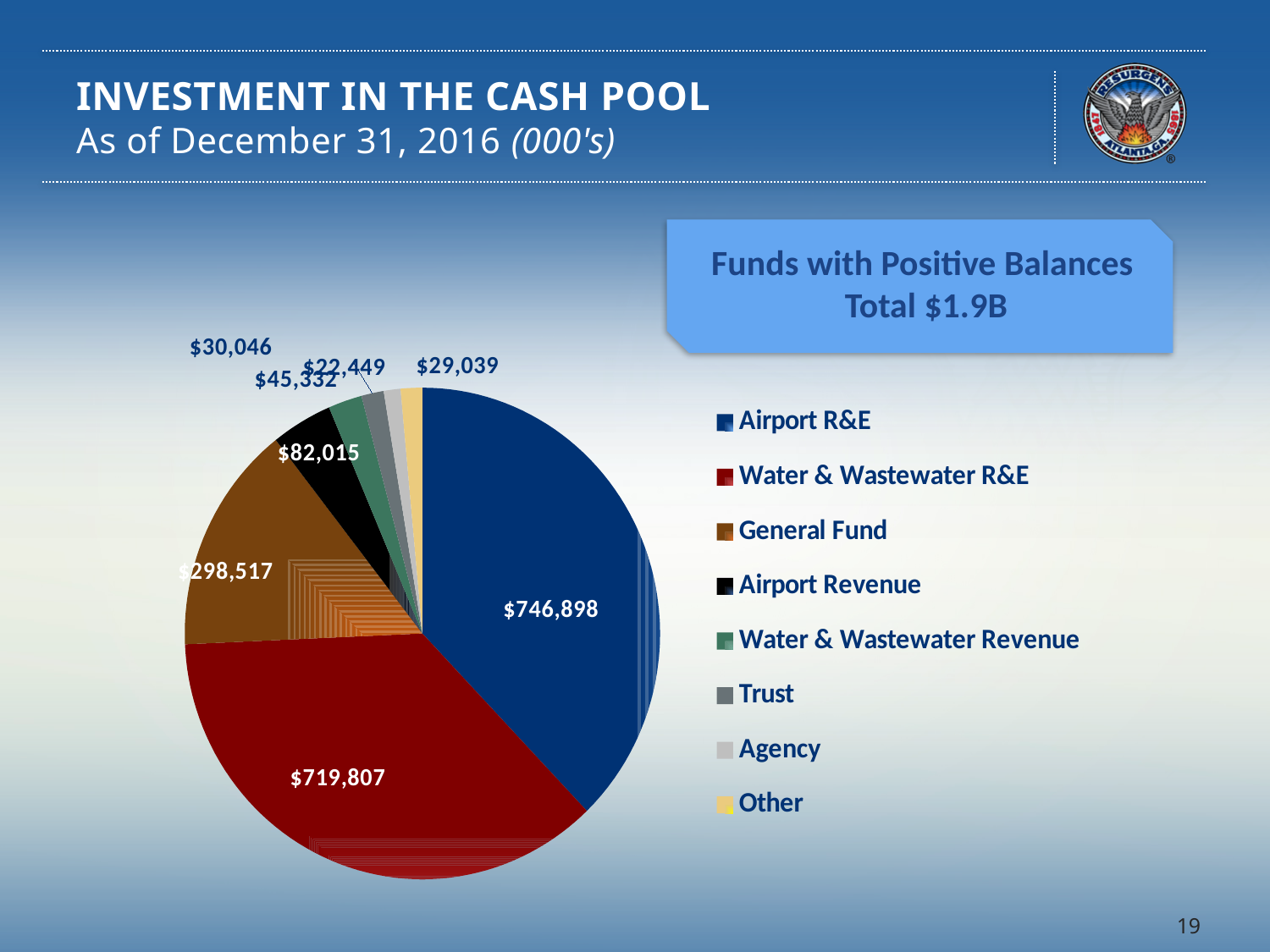
What is the value for Water & Wastewater R&E? $719,807 What type of chart is shown on the slide? pie chart What is the value for Airport Revenue? $82,015 What is the value for Other? $29,039 Which is larger, General Fund or Airport Revenue? General Fund How many funds are listed in the legend? 8 What is the value for General Fund? $298,517 What total is stated in the callout box for funds with positive balances? $1.9B Which fund has the largest slice of the pie? Airport R&E What is the difference between Airport R&E and Water & Wastewater R&E? $27,091 Which fund has the smallest slice of the pie? Agency What is the value for Airport R&E? $746,898